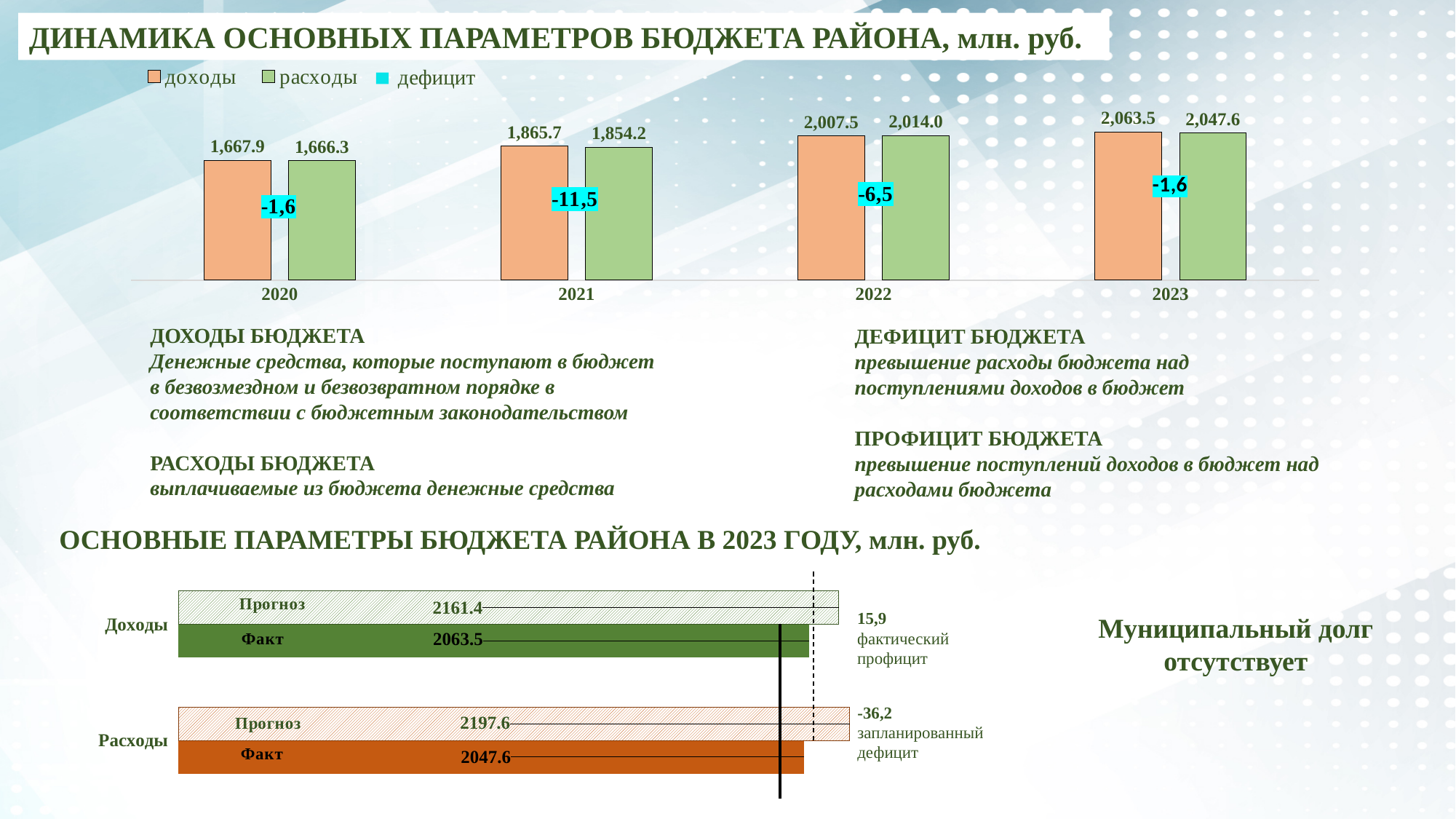
In the top chart 'ДИНАМИКА ОСНОВНЫХ ПАРАМЕТРОВ БЮДЖЕТА РАЙОНА', do the доходы values rise or fall from 2020 to 2023? rise In the top chart 'ДИНАМИКА ОСНОВНЫХ ПАРАМЕТРОВ БЮДЖЕТА РАЙОНА', what дефицит value is shown for 2021? -11,5 In the bottom chart 'ОСНОВНЫЕ ПАРАМЕТРЫ БЮДЖЕТА РАЙОНА В 2023 ГОДУ', what is the Прогноз value for Расходы? 2197.6 In the top chart 'ДИНАМИКА ОСНОВНЫХ ПАРАМЕТРОВ БЮДЖЕТА РАЙОНА', how many series does the legend list? 3 In the top chart 'ДИНАМИКА ОСНОВНЫХ ПАРАМЕТРОВ БЮДЖЕТА РАЙОНА', what is the difference between доходы in 2023 and доходы in 2020? 395.6 In the top chart 'ДИНАМИКА ОСНОВНЫХ ПАРАМЕТРОВ БЮДЖЕТА РАЙОНА', which year has the highest доходы value? 2023 In the top chart 'ДИНАМИКА ОСНОВНЫХ ПАРАМЕТРОВ БЮДЖЕТА РАЙОНА', what is the value of расходы for 2022? 2,014.0 In the top chart 'ДИНАМИКА ОСНОВНЫХ ПАРАМЕТРОВ БЮДЖЕТА РАЙОНА', what is the value of доходы for 2021? 1,865.7 In the bottom chart 'ОСНОВНЫЕ ПАРАМЕТРЫ БЮДЖЕТА РАЙОНА В 2023 ГОДУ', which is larger: the Факт value for Доходы or the Факт value for Расходы? Факт value for Доходы What kind of chart is the bottom chart 'ОСНОВНЫЕ ПАРАМЕТРЫ БЮДЖЕТА РАЙОНА В 2023 ГОДУ'? bar chart In the top chart 'ДИНАМИКА ОСНОВНЫХ ПАРАМЕТРОВ БЮДЖЕТА РАЙОНА', how many years are shown on the x axis? 4 In the top chart 'ДИНАМИКА ОСНОВНЫХ ПАРАМЕТРОВ БЮДЖЕТА РАЙОНА', which year has the lowest расходы value? 2020